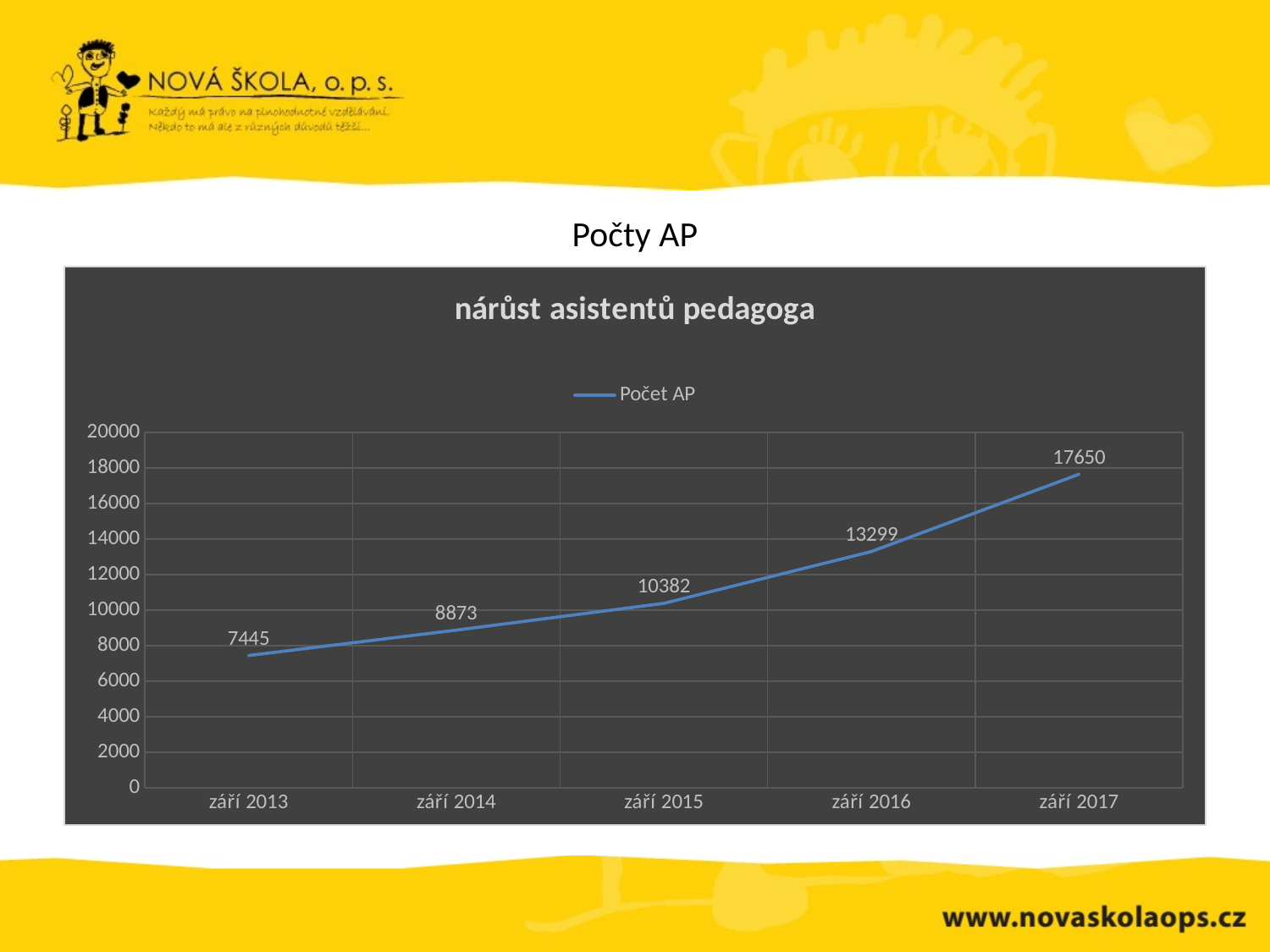
What is the difference between the Počet AP values for září 2014 and září 2013? 1428 What is the value of Počet AP for září 2017? 17650 Which point on the x axis has the lowest value of Počet AP? září 2013 What is the value of Počet AP for září 2015? 10382 How many data points are plotted on the chart? 5 What is the value of Počet AP for září 2013? 7445 Do the values rise or fall from září 2013 to září 2017? rise Which is larger, the Počet AP value for září 2016 or for září 2015? září 2016 Is the value for září 2016 greater or less than 12000? greater What is the difference between the Počet AP values for září 2017 and září 2016? 4351 What kind of chart is shown on the slide? line chart Which point on the x axis has the highest value of Počet AP? září 2017